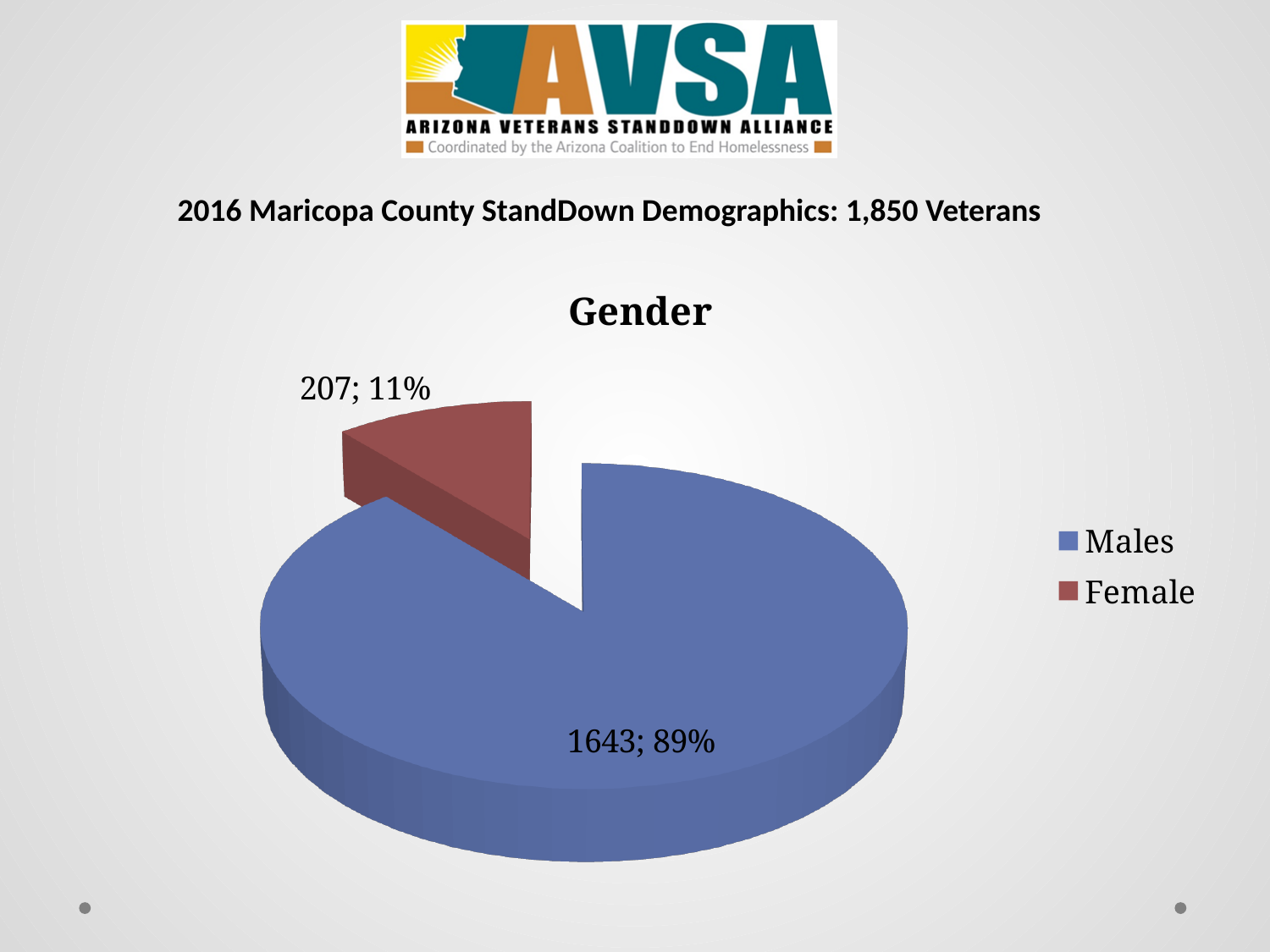
What kind of chart is shown on the slide? pie chart Which category has the smallest slice? Female What is the difference between the Males value and the Female value? 1436 Which colour represents Female in the chart? red What share of the pie does the Female slice represent? 11% How many entries does the legend list? 2 What share of the pie does the Males slice represent? 89% How many slices does the pie chart have? 2 What is the title of the chart? Gender Which category has the largest slice? Males What is the value for Males? 1643 What is the value for Female? 207